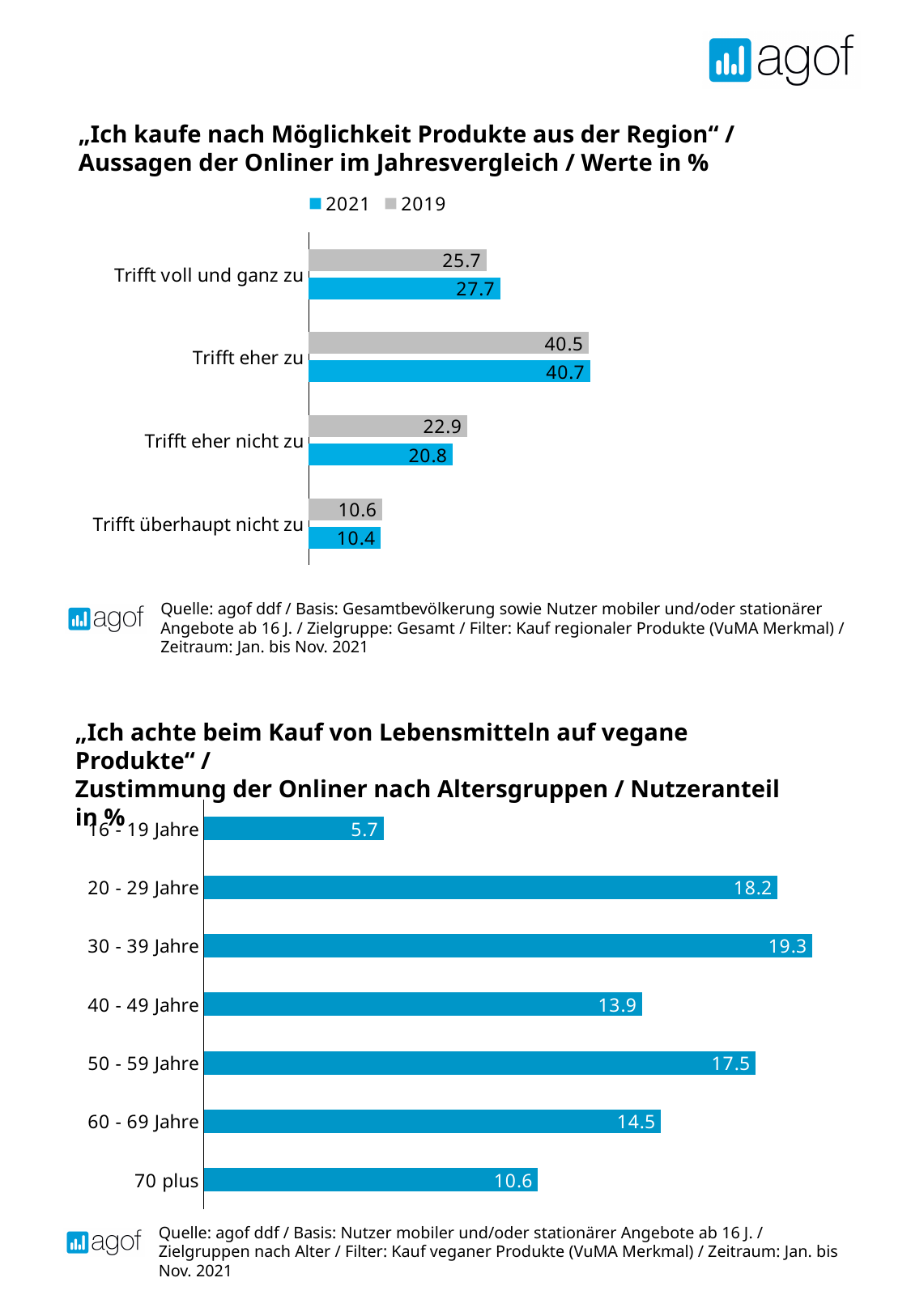
In the bottom chart ("Ich achte beim Kauf von Lebensmitteln auf vegane Produkte"), which age group has the highest value? 30 - 39 Jahre In the top chart ("Ich kaufe nach Möglichkeit Produkte aus der Region"), what is the difference between the 2021 and 2019 values for "Trifft voll und ganz zu"? 2.0 In the top chart ("Ich kaufe nach Möglichkeit Produkte aus der Region"), which colour represents 2019? Grey In the top chart ("Ich kaufe nach Möglichkeit Produkte aus der Region"), how many series does the legend list? 2 What kind of chart is the bottom chart ("Ich achte beim Kauf von Lebensmitteln auf vegane Produkte")? Bar chart In the top chart ("Ich kaufe nach Möglichkeit Produkte aus der Region"), what is the 2019 value for "Trifft eher nicht zu"? 22.9 In the top chart ("Ich kaufe nach Möglichkeit Produkte aus der Region"), what is the 2021 value for "Trifft eher zu"? 40.7 In the bottom chart ("Ich achte beim Kauf von Lebensmitteln auf vegane Produkte"), which age group has the lowest value? 16 - 19 Jahre In the bottom chart ("Ich achte beim Kauf von Lebensmitteln auf vegane Produkte"), which is larger: the value for "40 - 49 Jahre" or "60 - 69 Jahre"? 60 - 69 Jahre In the bottom chart ("Ich achte beim Kauf von Lebensmitteln auf vegane Produkte"), how many age groups are shown? 7 In the top chart ("Ich kaufe nach Möglichkeit Produkte aus der Region"), which category has the lowest 2021 value? Trifft überhaupt nicht zu In the bottom chart ("Ich achte beim Kauf von Lebensmitteln auf vegane Produkte"), what is the value for "50 - 59 Jahre"? 17.5